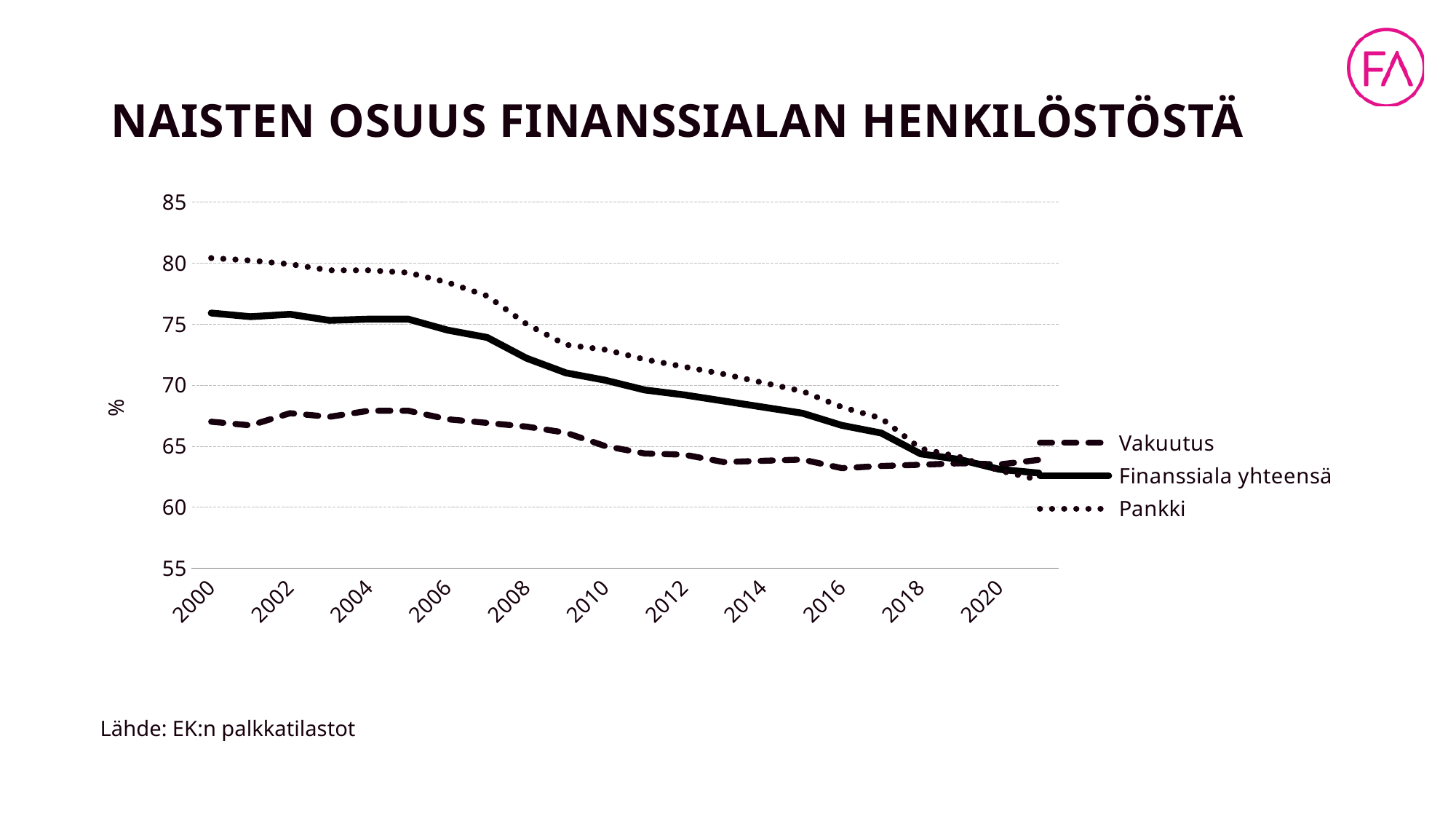
Which series has the lowest value in 2000? Vakuutus Is the value for Pankki in 2000 greater or less than 75? greater Does the Pankki series rise or fall from 2000 to 2020? fall In 2008, which series has the larger value, Pankki or Vakuutus? Pankki What kind of chart is shown on the slide? line chart Which series has the highest value in 2000? Pankki Is the value for Vakuutus in 2000 greater or less than 70? less What is the title of the chart? NAISTEN OSUUS FINANSSIALAN HENKILÖSTÖSTÄ Is the value for Finanssiala yhteensä in 2020 greater or less than 65? less Which series is drawn with a dotted line? Pankki How many series does the legend list? 3 Does the Finanssiala yhteensä series rise or fall from 2000 to 2020? fall